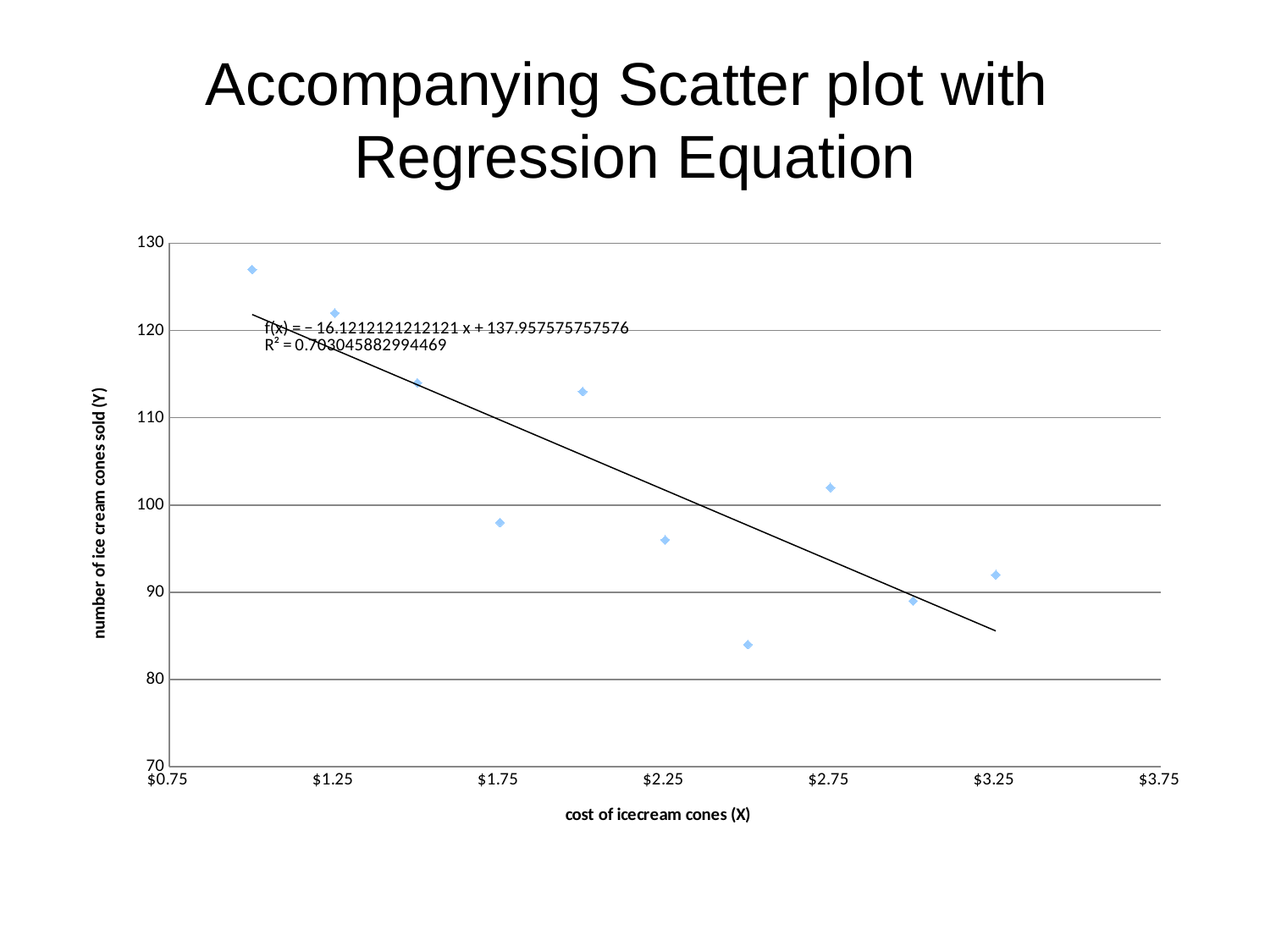
Is the lowest point on the scatter plot greater or less than 90? less Do the number of ice cream cones sold generally rise or fall as the cost of ice cream cones increases? fall What is the R² value shown for the regression line? 0.703045882994469 Is the value for the point at $1.75 greater or less than 110? less What kind of chart is shown on the slide? scatter plot Is the value for the point at $2.25 greater or less than 110? less How many data points are plotted on the scatter plot? 10 What is the title of the x axis? cost of icecream cones (X) Which point has the higher number of ice cream cones sold, the one at $1.25 or the one at $3.25? $1.25